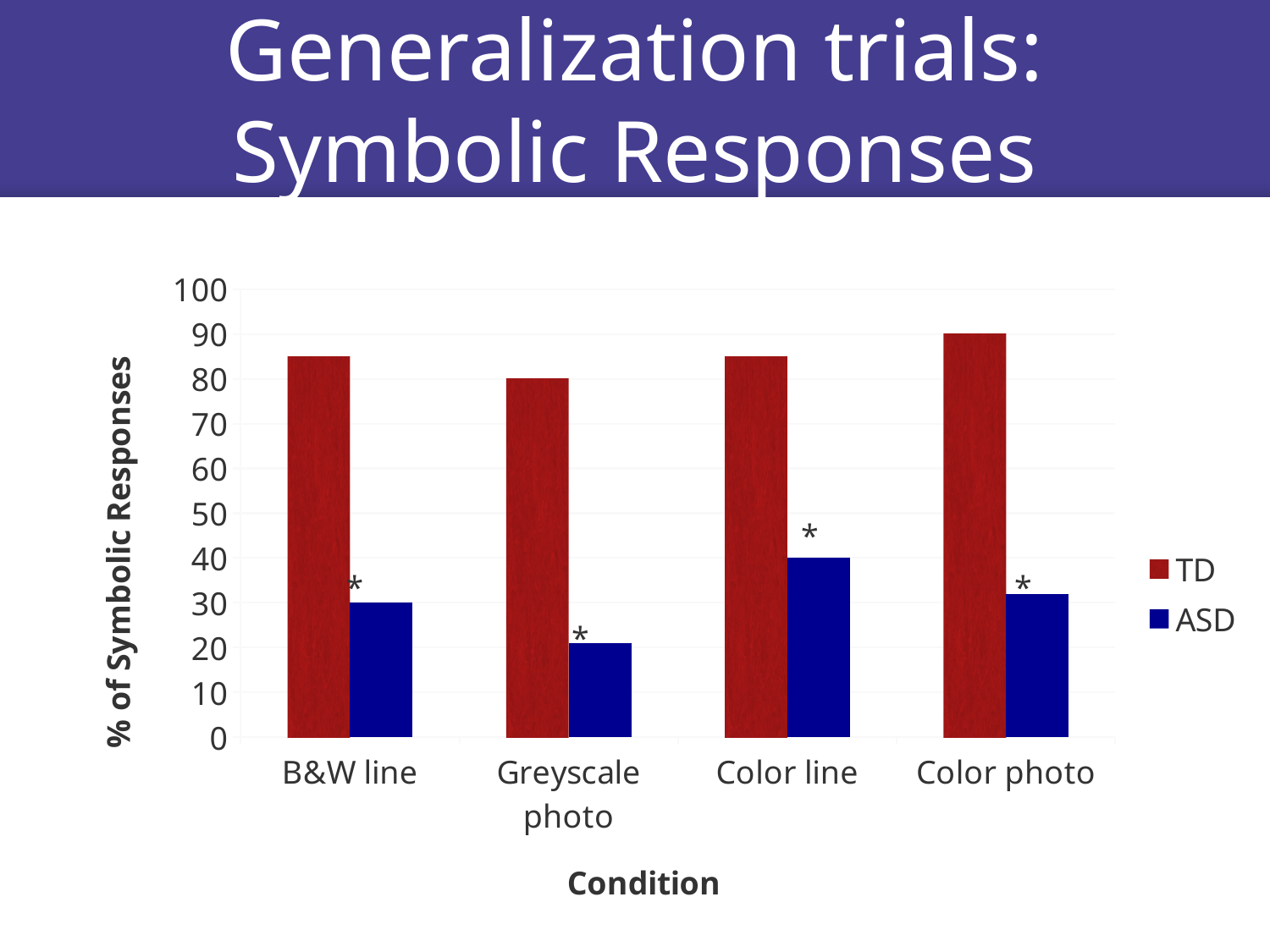
Is the ASD value for Color photo greater or less than 40? less Which condition has the lowest ASD value? Greyscale photo Which condition has the highest ASD value? Color line What kind of chart is shown on the slide? bar chart Is the ASD value for Greyscale photo greater or less than 30? less For the Color line condition, which series has the larger value, TD or ASD? TD Is the TD value for B&W line greater or less than 80? greater Which condition has the highest TD value? Color photo What is the label of the y axis? % of Symbolic Responses How many series does the legend list? 2 Which condition has the lowest TD value? Greyscale photo How many conditions are shown on the x axis? 4